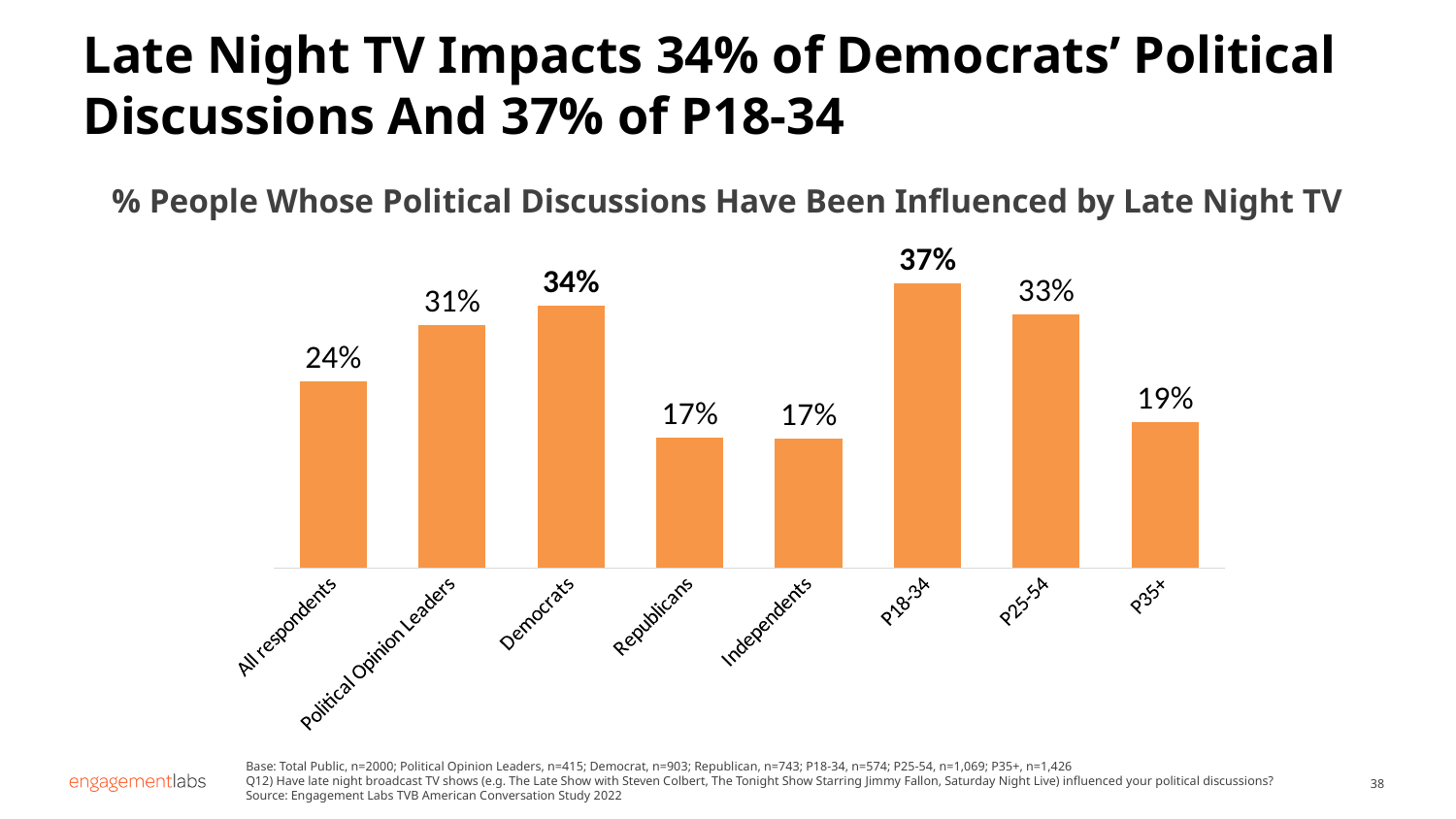
What is the difference between the values for P18-34 and P35+? 18% What is the value for P35+? 19% What kind of chart is shown on the slide? Bar chart What is the value for Political Opinion Leaders? 31% Which is larger, the value for P25-54 or the value for All respondents? P25-54 Do Republicans and Independents have the same value? Yes, 17% What is the difference between the values for Democrats and Republicans? 17% Which category has the highest value? P18-34 How many categories are shown on the x axis? 8 What is the value for Democrats? 34% What is the title of the chart? % People Whose Political Discussions Have Been Influenced by Late Night TV What is the value for All respondents? 24%